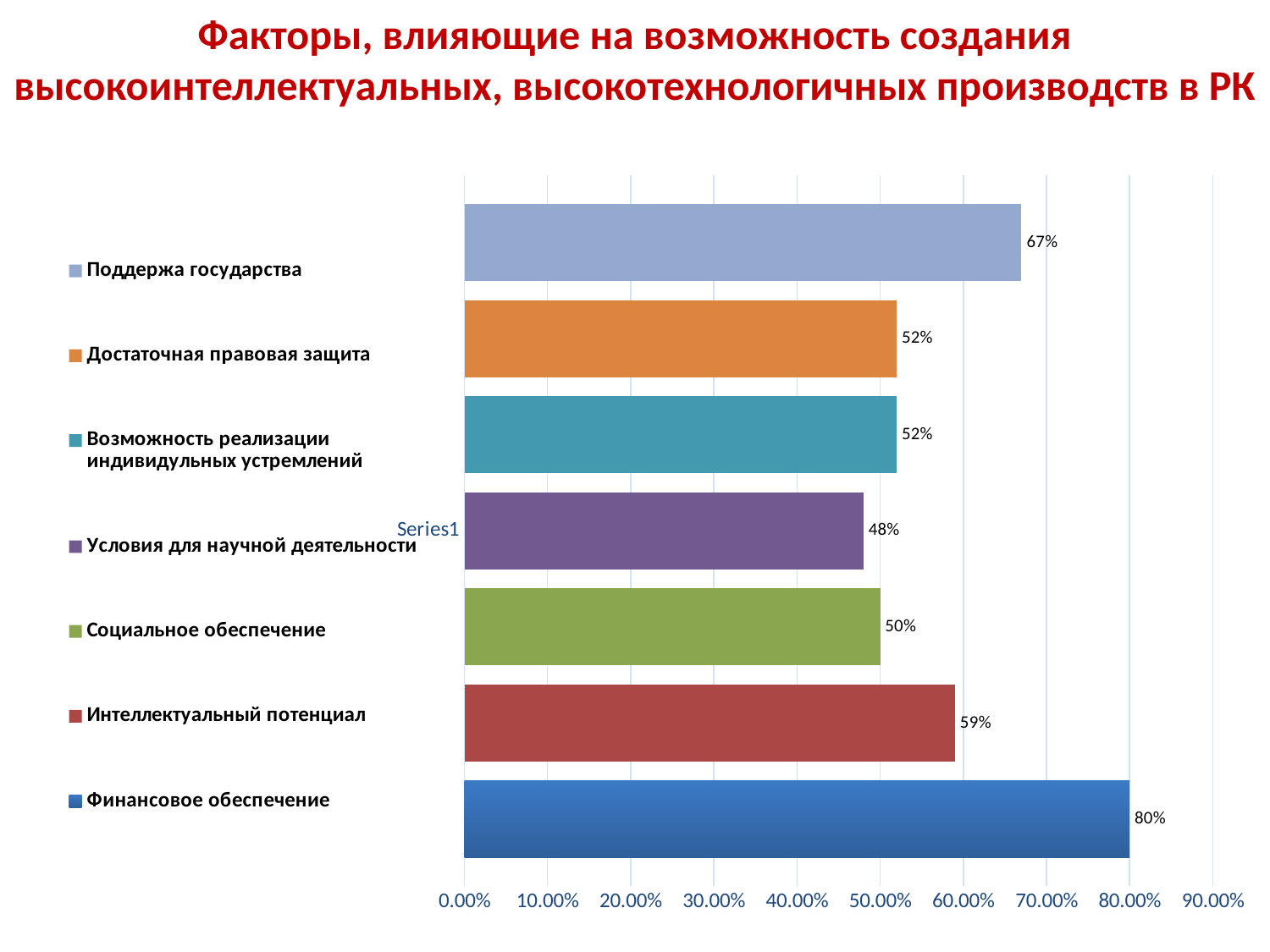
What is the difference between the values for Финансовое обеспечение and Поддержа государства? 13% What is the value for Интеллектуальный потенциал? 59% Which is larger, the value for Интеллектуальный потенциал or the value for Достаточная правовая защита? Интеллектуальный потенциал Which factor has the highest value? Финансовое обеспечение How many bars are plotted in the chart? 7 What is the value for Поддержа государства? 67% Which factor has the lowest value? Условия для научной деятельности What is the value for Условия для научной деятельности? 48% What is the difference between the values for Интеллектуальный потенциал and Социальное обеспечение? 9% What is the value for Финансовое обеспечение? 80% What kind of chart is shown on the slide? Bar chart What colour is the bar for Социальное обеспечение? Green